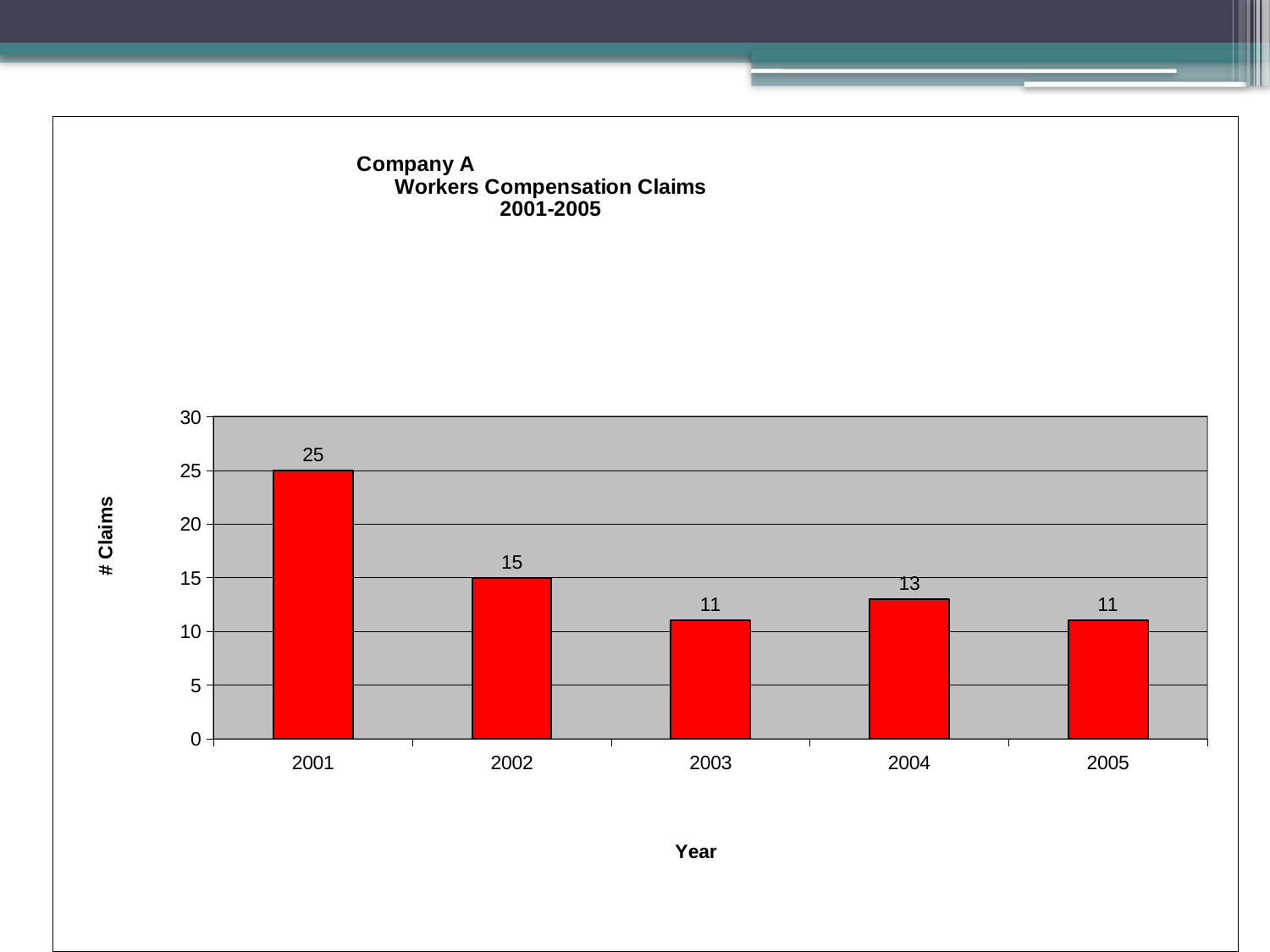
Which year had more claims, 2002 or 2004? 2002 What is the number of claims shown for 2002? 15 How many workers compensation claims did Company A have in 2001? 25 What kind of chart is shown on the slide? Bar chart What is the label on the y axis of the chart? # Claims Do the claims generally rise or fall from 2001 to 2005? Fall What is the difference in claims between 2001 and 2002? 10 What is the number of claims shown for 2004? 13 What is the difference in claims between 2004 and 2005? 2 Which year has the highest number of claims? 2001 How many years are shown on the x axis? 5 Is the value for 2001 greater or less than 20? greater